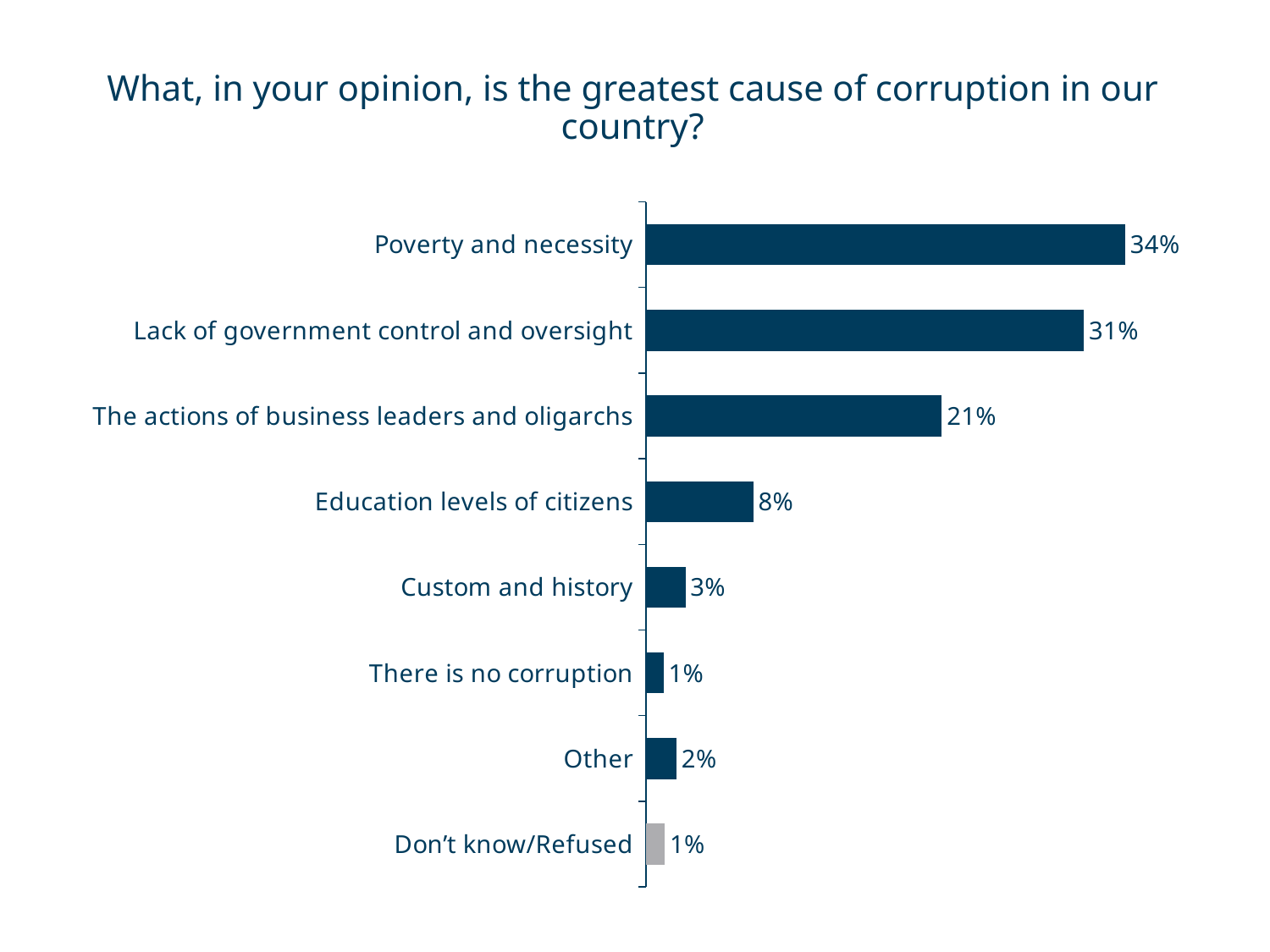
What is the value for Education levels of citizens? 8% What kind of chart is shown on the slide? Bar chart How many categories are shown in the chart? 8 Which is larger, Custom and history or Other? Custom and history Which category has the highest value? Poverty and necessity What percentage is shown for The actions of business leaders and oligarchs? 21% What is the value for Lack of government control and oversight? 31% What percentage of respondents answered Custom and history? 3% What is the difference between The actions of business leaders and oligarchs and Education levels of citizens? 13% Which category's bar is shown in grey rather than dark blue? Don't know/Refused What percentage of respondents chose Poverty and necessity as the greatest cause of corruption? 34% What is the difference between Poverty and necessity and Lack of government control and oversight? 3%